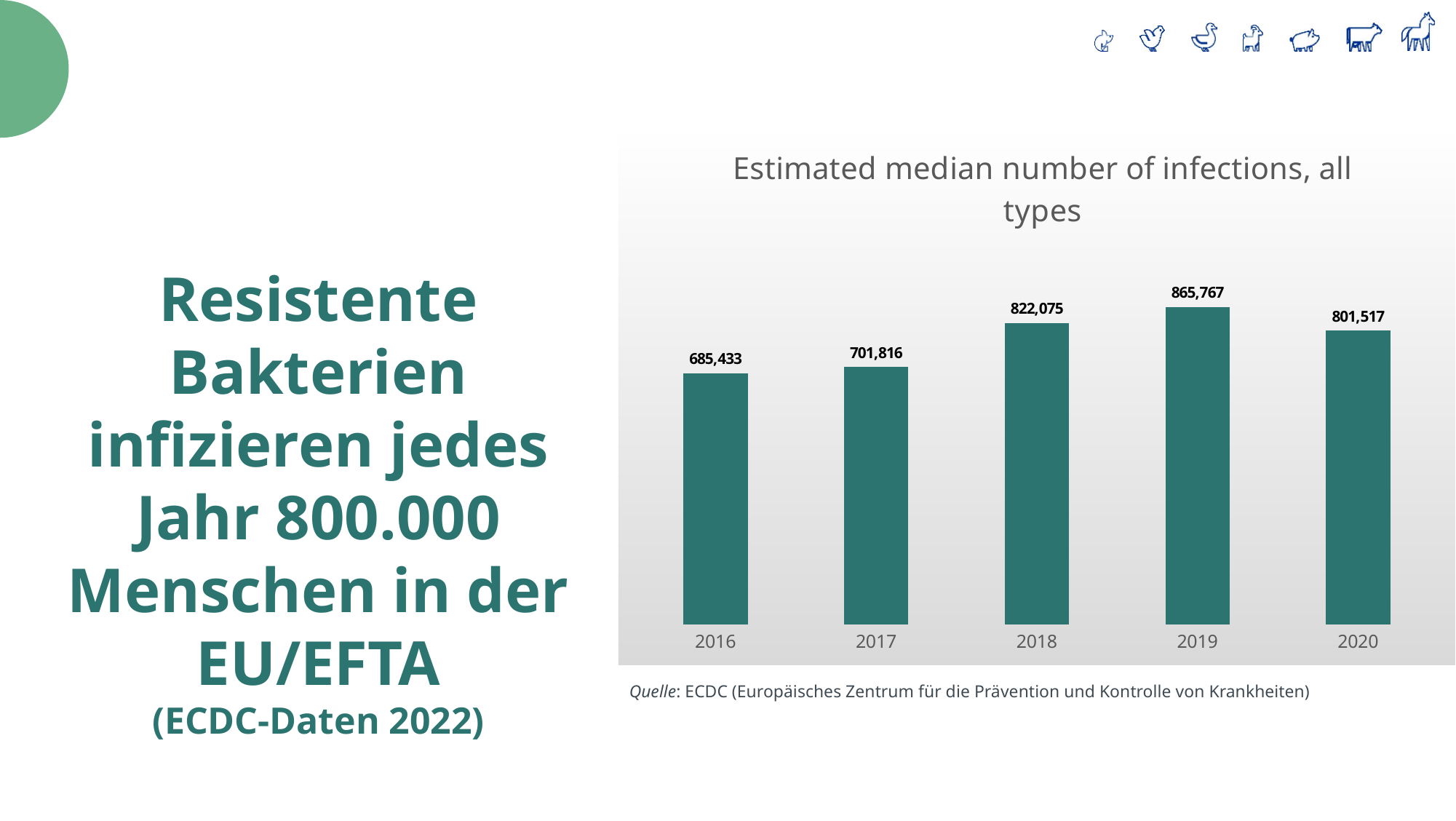
What is the estimated median number of infections for 2019? 865,767 What is the estimated median number of infections for 2020? 801,517 Which is larger, the value for 2018 or the value for 2020? 2018 What is the difference between the values for 2017 and 2016? 16,383 What is the title of the chart? Estimated median number of infections, all types Do the values rise or fall from 2016 to 2019? Rise How many years are shown on the x axis of the chart? 5 What is the estimated median number of infections for 2016? 685,433 Which year has the highest estimated median number of infections? 2019 Which year has the lowest estimated median number of infections? 2016 What is the difference between the values for 2019 and 2020? 64,250 What kind of chart is shown on the slide? Bar chart